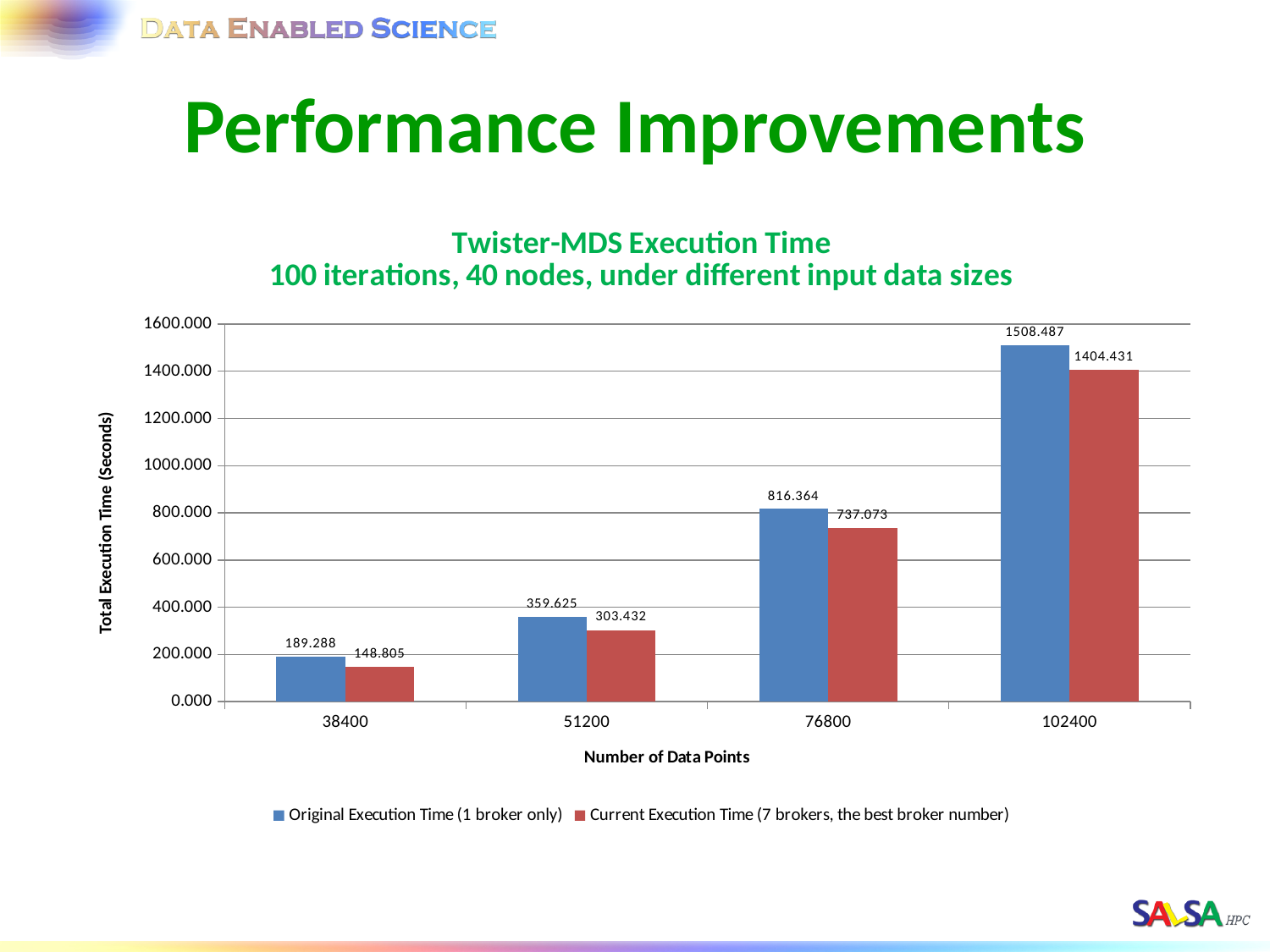
Which number of data points has the highest Original Execution Time? 102400 How many series does the legend list? 2 How many data point sizes are shown on the x axis? 4 At 76800 data points, which is larger: the Original Execution Time or the Current Execution Time? Original Execution Time What is the Current Execution Time (7 brokers) for 51200 data points? 303.432 What is the difference between the Original and Current Execution Time at 38400 data points? 40.483 What kind of chart is shown on the slide? Bar chart What is the Original Execution Time (1 broker only) for 38400 data points? 189.288 Which number of data points has the lowest Current Execution Time? 38400 What is the difference between the Original and Current Execution Time at 102400 data points? 104.056 What is the Original Execution Time (1 broker only) for 76800 data points? 816.364 What is the Current Execution Time (7 brokers) for 102400 data points? 1404.431